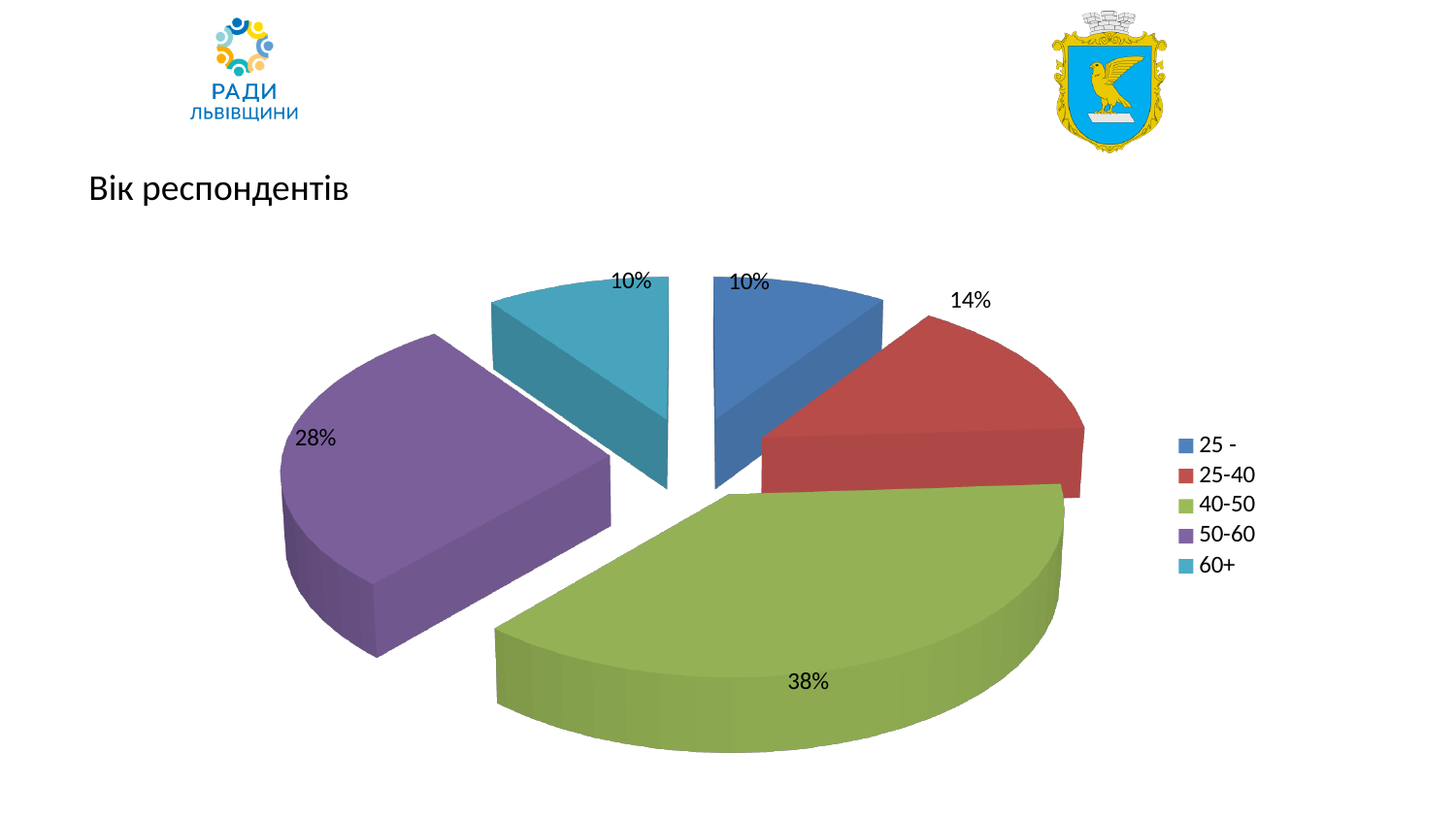
What share of respondents is in the 40-50 age group? 38% What type of chart is shown on the slide? pie chart What share of respondents is in the 50-60 age group? 28% Which age group has the largest share of respondents? 40-50 Which colour represents the 50-60 age group in the chart? purple What share of respondents is in the 60+ age group? 10% How many categories does the legend list? 5 What is the difference in percentage points between the 25-40 and 60+ age groups? 4 What is the title of the chart? Вік респондентів What share of respondents is in the 25-40 age group? 14% Which is larger, the share for 25-40 or the share for 50-60? 50-60 What is the difference in percentage points between the 40-50 and 50-60 age groups? 10